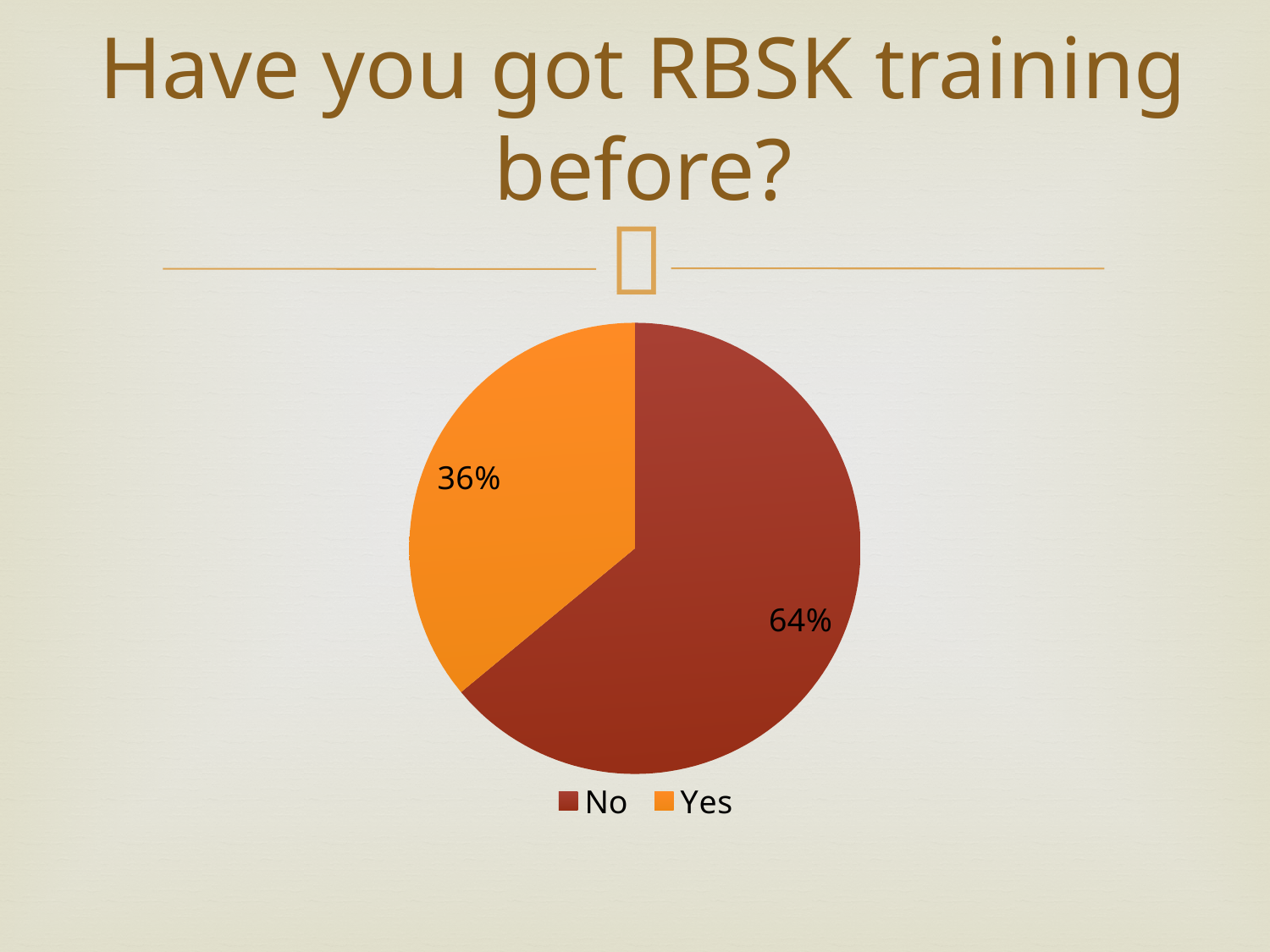
Which is larger, the "Yes" slice or the "No" slice? No Which response has the largest share of the pie? No What colour is the "Yes" slice of the pie chart? orange What is the title of the slide containing the pie chart? Have you got RBSK training before? How many entries does the legend list? 2 What percentage of respondents answered "Yes"? 36% What percentage of respondents answered "No"? 64% What kind of chart is shown on the slide? pie chart What is the difference in percentage points between the "No" and "Yes" slices? 28 What share of the pie does the "No" slice represent? 64% Which response has the smallest share of the pie? Yes How many slices does the pie chart have? 2